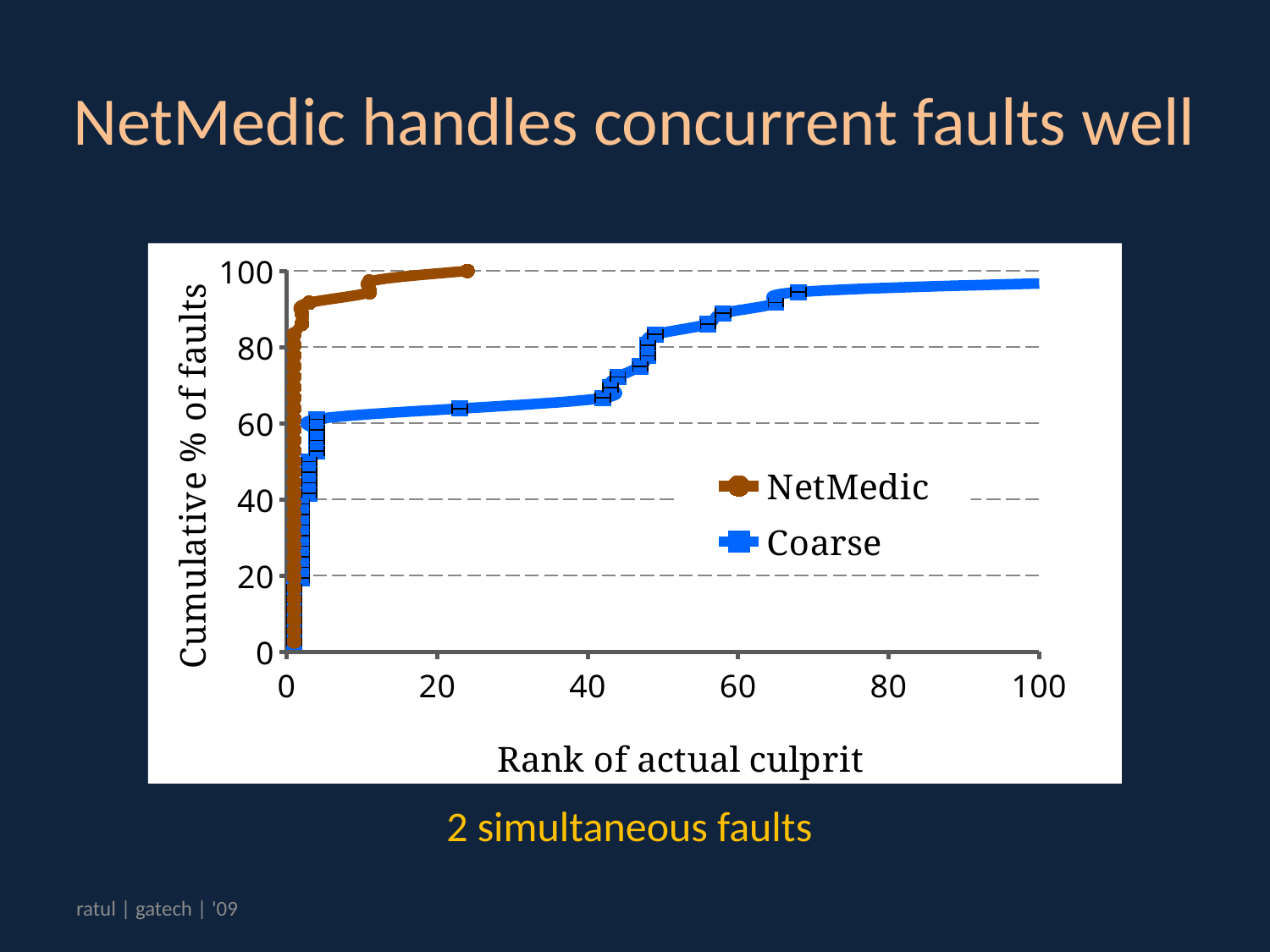
At a rank of 20, is the cumulative % of faults for Coarse greater or less than 80? less What kind of chart is shown on the slide? line chart At a rank of 20, is the cumulative % of faults for NetMedic greater or less than 80? greater Which series reaches 100% cumulative faults at a lower rank, NetMedic or Coarse? NetMedic What is the label of the x axis? Rank of actual culprit Does the Coarse series rise or fall as the rank of actual culprit increases? rise At a rank of 20, which series has the higher cumulative % of faults, NetMedic or Coarse? NetMedic What are the two series named in the legend? NetMedic and Coarse How many series does the legend list? 2 At a rank of 10, is the cumulative % of faults for NetMedic greater or less than 80? greater